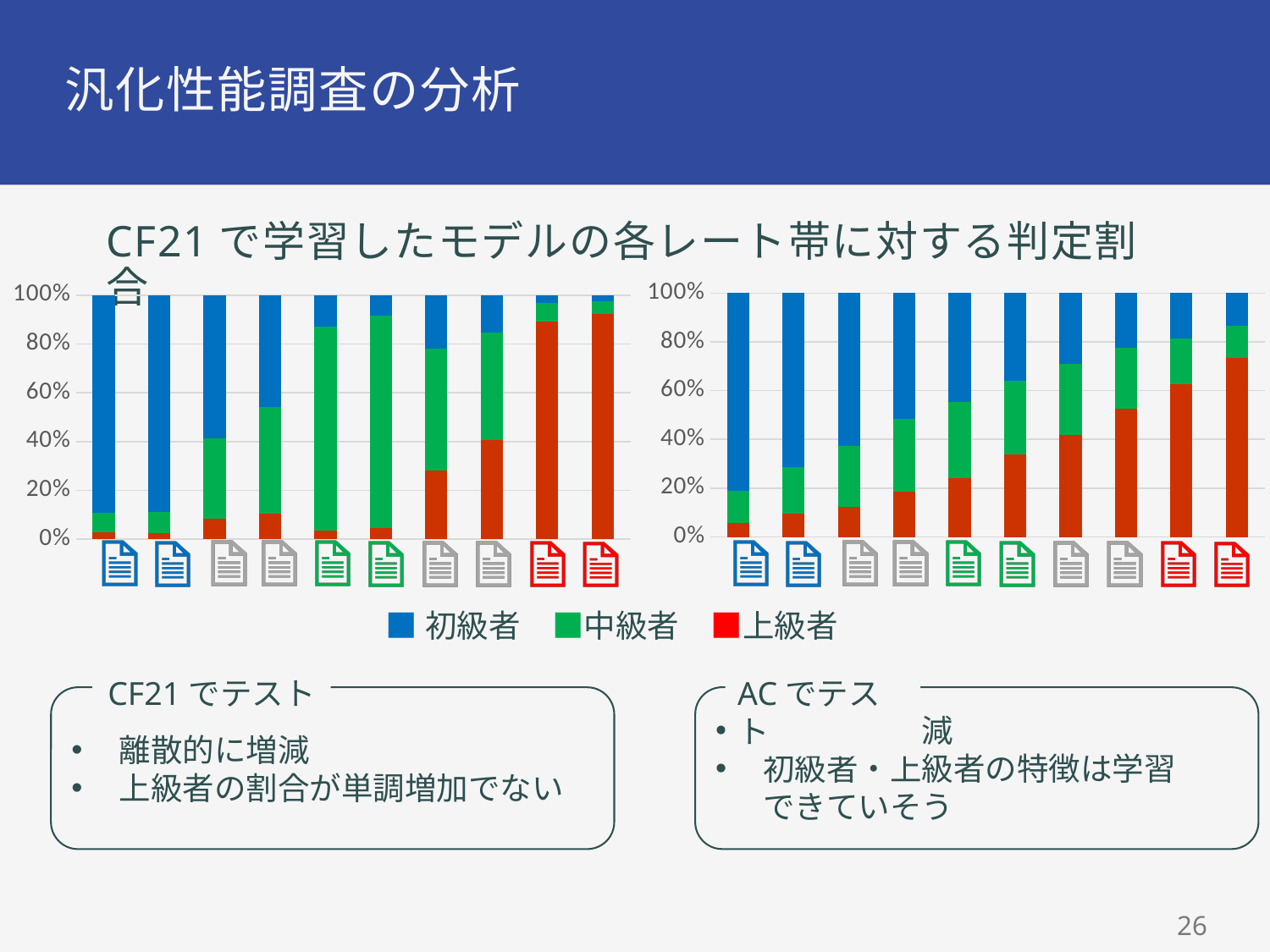
How many bars does the left chart contain? 10 In the right chart, is the 上級者 (red) share of the rightmost bar greater or less than 60%? greater Which is larger: the 上級者 (red) share of the rightmost bar in the left chart or the 上級者 share of the rightmost bar in the right chart? The left chart's rightmost bar How many series does the legend list for the charts? 3 Which colour represents 上級者 in the legend? Red In the right chart, does the 上級者 (red) share rise or fall from the leftmost bar to the rightmost bar? Rises How many bars does the right chart contain? 10 In the right chart, is the 上級者 (red) share of the leftmost bar greater or less than 20%? less What kind of chart is the left chart on the slide? Stacked bar chart In the left chart, is the 上級者 (red) share of the rightmost bar greater or less than 80%? greater In the right chart, does the 初級者 (blue) share rise or fall from the leftmost bar to the rightmost bar? Falls